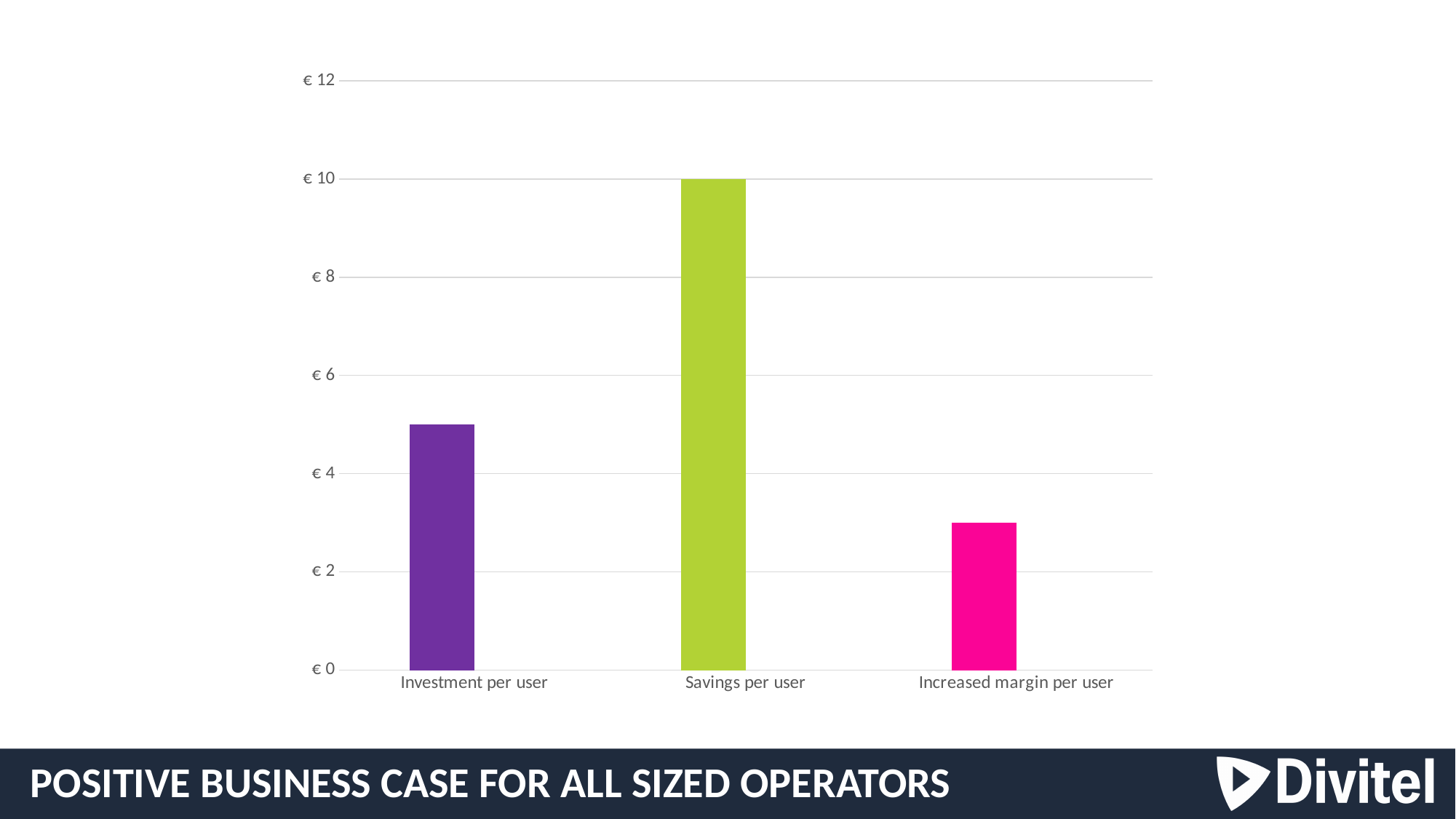
Is the value for Investment per user greater or less than € 6? less Which is larger, Investment per user or Increased margin per user? Investment per user What is the highest value shown on the vertical axis? € 12 Which category has the lowest value? Increased margin per user What colour is the bar for Savings per user? Green How many categories are plotted in the chart? 3 Is the value for Increased margin per user greater or less than € 4? less Which category has the highest value? Savings per user What is the value for Savings per user? € 10 Is the value for Increased margin per user greater or less than € 2? greater What type of chart is shown on the slide? Bar chart